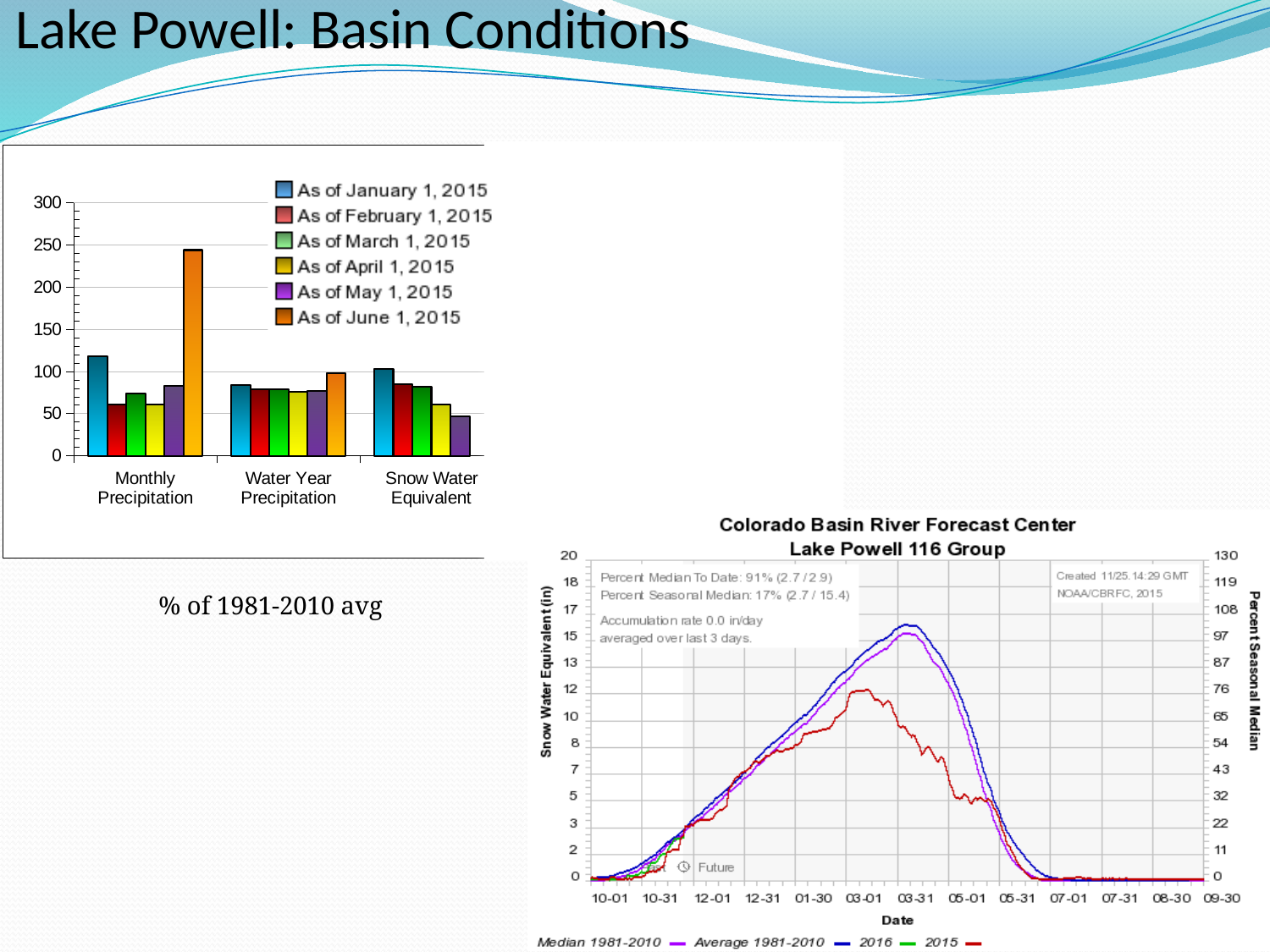
In the bar chart on the left, for Monthly Precipitation, which is larger: the value As of January 1, 2015 or As of February 1, 2015? As of January 1, 2015 In the bar chart on the left, how many series does the legend list? 6 What kind of chart is the Colorado Basin River Forecast Center chart on the right? line chart In the Lake Powell 116 Group line chart, how many series does the legend list? 4 In the bar chart on the left, which series has the highest value for Monthly Precipitation? As of June 1, 2015 In the bar chart on the left, how many categories are shown on the x axis? 3 In the bar chart on the left, is the Snow Water Equivalent value As of April 1, 2015 greater or less than 100? less In the bar chart on the left, which series has the lowest value for Snow Water Equivalent? As of May 1, 2015 In the Lake Powell 116 Group line chart, what Percent Median To Date is printed on the chart? 91% What kind of chart is the chart on the left of the slide? bar chart In the Lake Powell 116 Group line chart, what is the label of the left vertical axis? Snow Water Equivalent (in) In the bar chart on the left, is the Monthly Precipitation value As of June 1, 2015 greater or less than 200? greater